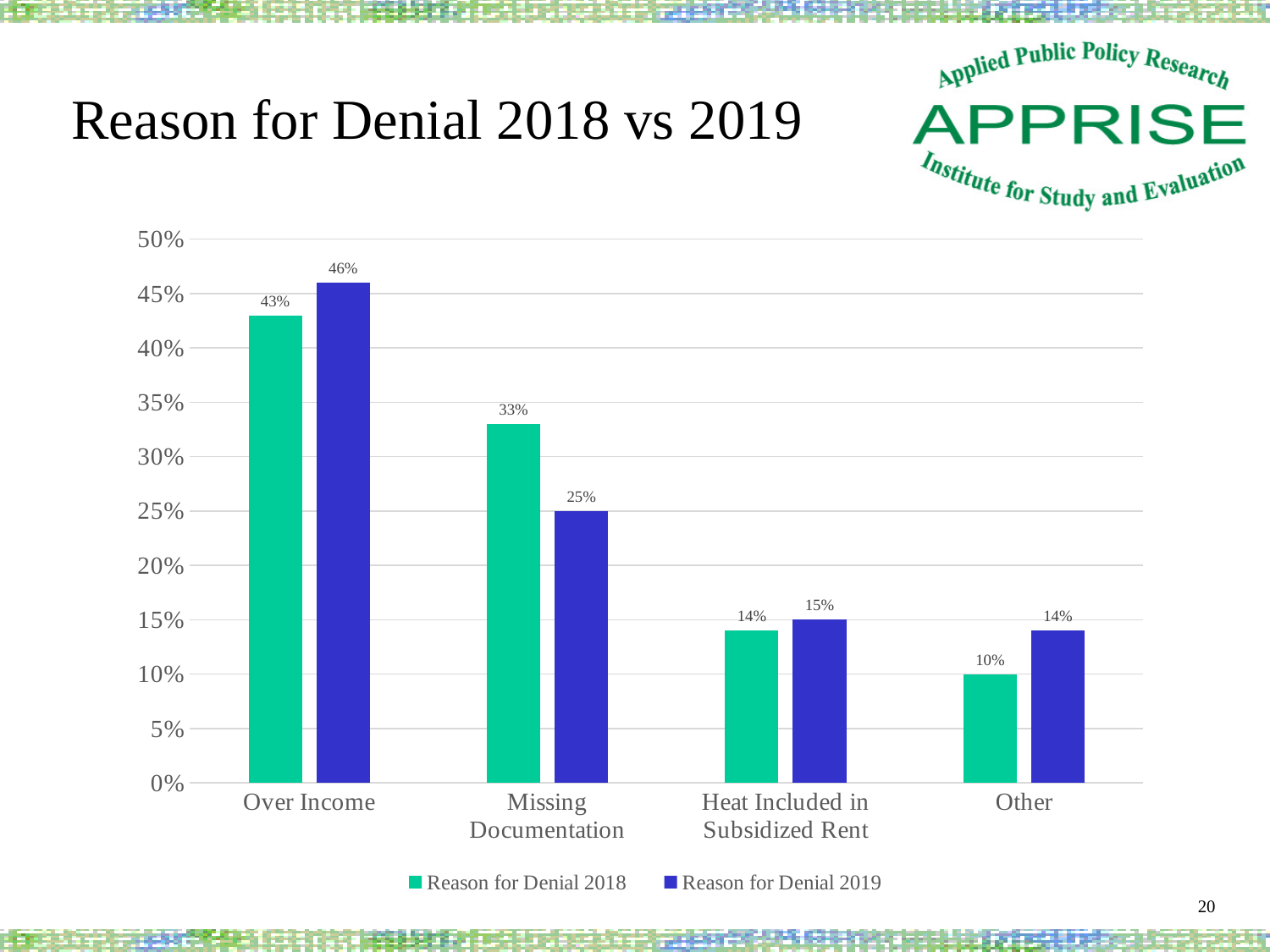
Which category has the highest value in the Reason for Denial 2018 series? Over Income What is the title of the slide? Reason for Denial 2018 vs 2019 Which category has the lowest value in the Reason for Denial 2019 series? Other What is the value for Missing Documentation in the Reason for Denial 2018 series? 33% What is the difference between the 2018 and 2019 values for Missing Documentation? 8% What is the value for Other in the Reason for Denial 2018 series? 10% How many categories are shown on the x axis? 4 Is the value for Heat Included in Subsidized Rent in the Reason for Denial 2018 series greater or less than 20%? less How many series does the legend list? 2 What is the value for Over Income in the Reason for Denial 2019 series? 46% Which is larger for Over Income: the Reason for Denial 2018 value or the Reason for Denial 2019 value? Reason for Denial 2019 What kind of chart is shown on the slide? bar chart